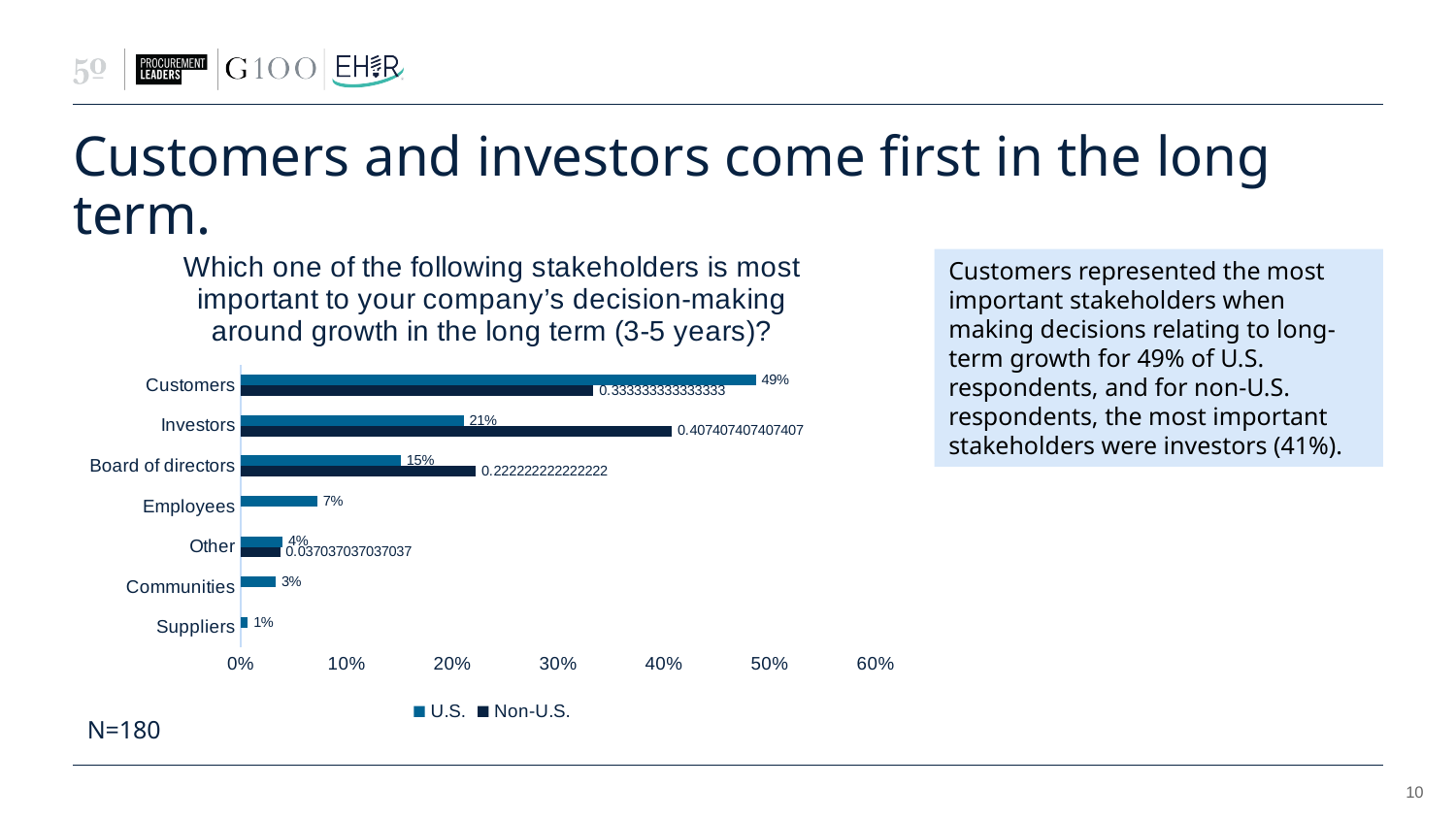
What is the U.S. value for Customers? 49% What kind of chart is shown on the slide? bar chart Which category has the lowest U.S. value? Suppliers What is the Non-U.S. value for Investors as printed on the chart? 0.407407407407407 Which category has the highest Non-U.S. value? Investors What is the Non-U.S. value for Other as printed on the chart? 0.037037037037037 Which category has the highest U.S. value? Customers How many series does the chart legend list? 2 How many stakeholder categories are shown on the chart? 7 For Investors, which series has the larger value, U.S. or Non-U.S.? Non-U.S. What is the difference between the U.S. values for Customers and Investors? 28% What is the U.S. value for Board of directors? 15%